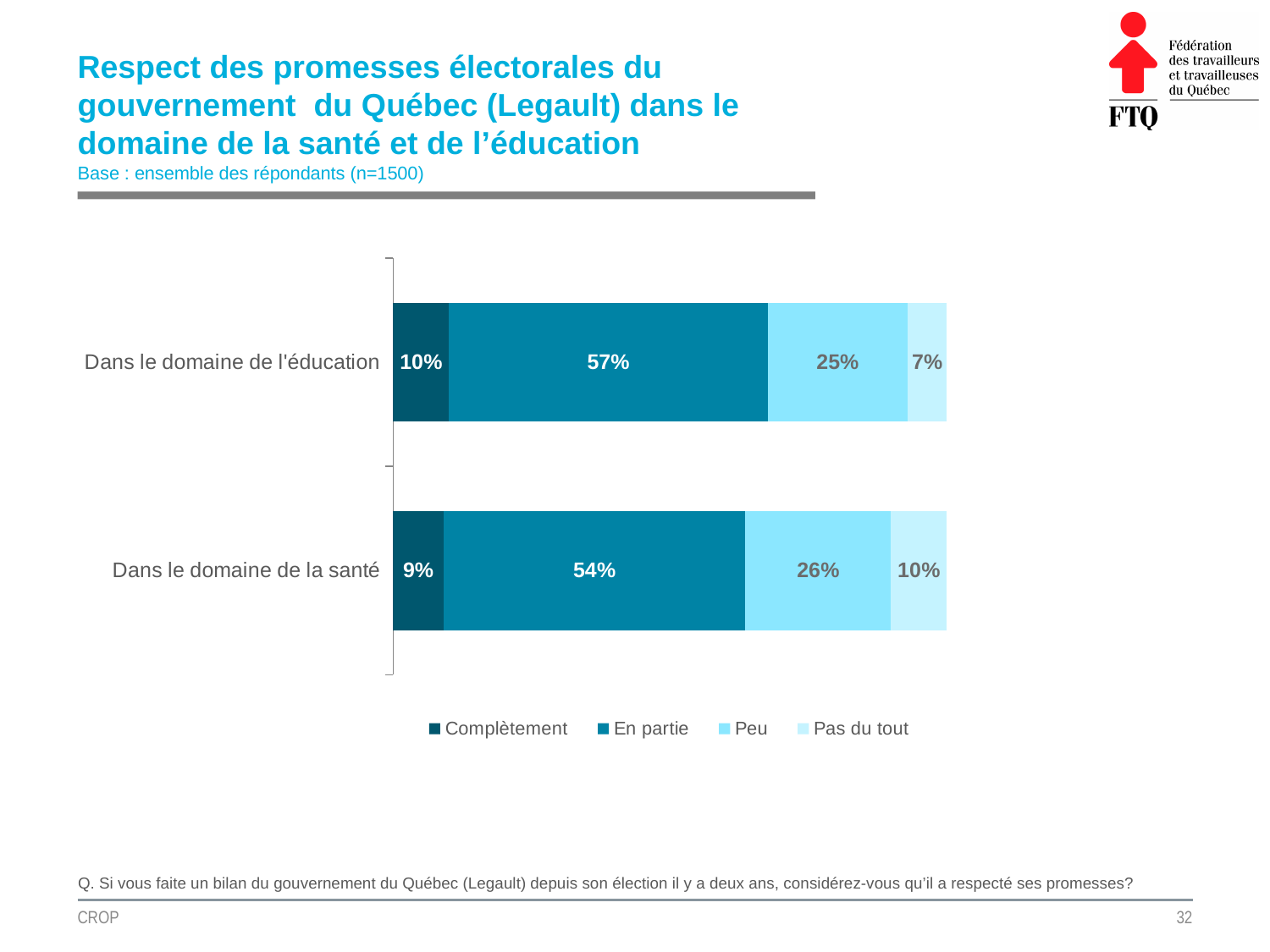
Which is larger: "Pas du tout" for education or "Pas du tout" for health? Pas du tout for health Which response category has the lowest value in the "Dans le domaine de l'éducation" bar? Pas du tout What kind of chart is shown on the slide? Stacked bar chart What is the total of the "Dans le domaine de l'éducation" bar? 99% What is the value for "En partie" in the "Dans le domaine de l'éducation" bar? 57% What is the value for "Pas du tout" in the "Dans le domaine de la santé" bar? 10% What is the value for "Complètement" in the "Dans le domaine de la santé" bar? 9% What is the difference between the "En partie" values for education and health? 3% What is the value for "Peu" in the "Dans le domaine de l'éducation" bar? 25% How many series does the legend list? 4 Which response category has the highest value in the "Dans le domaine de la santé" bar? En partie How many categories (bars) are shown in the chart? 2